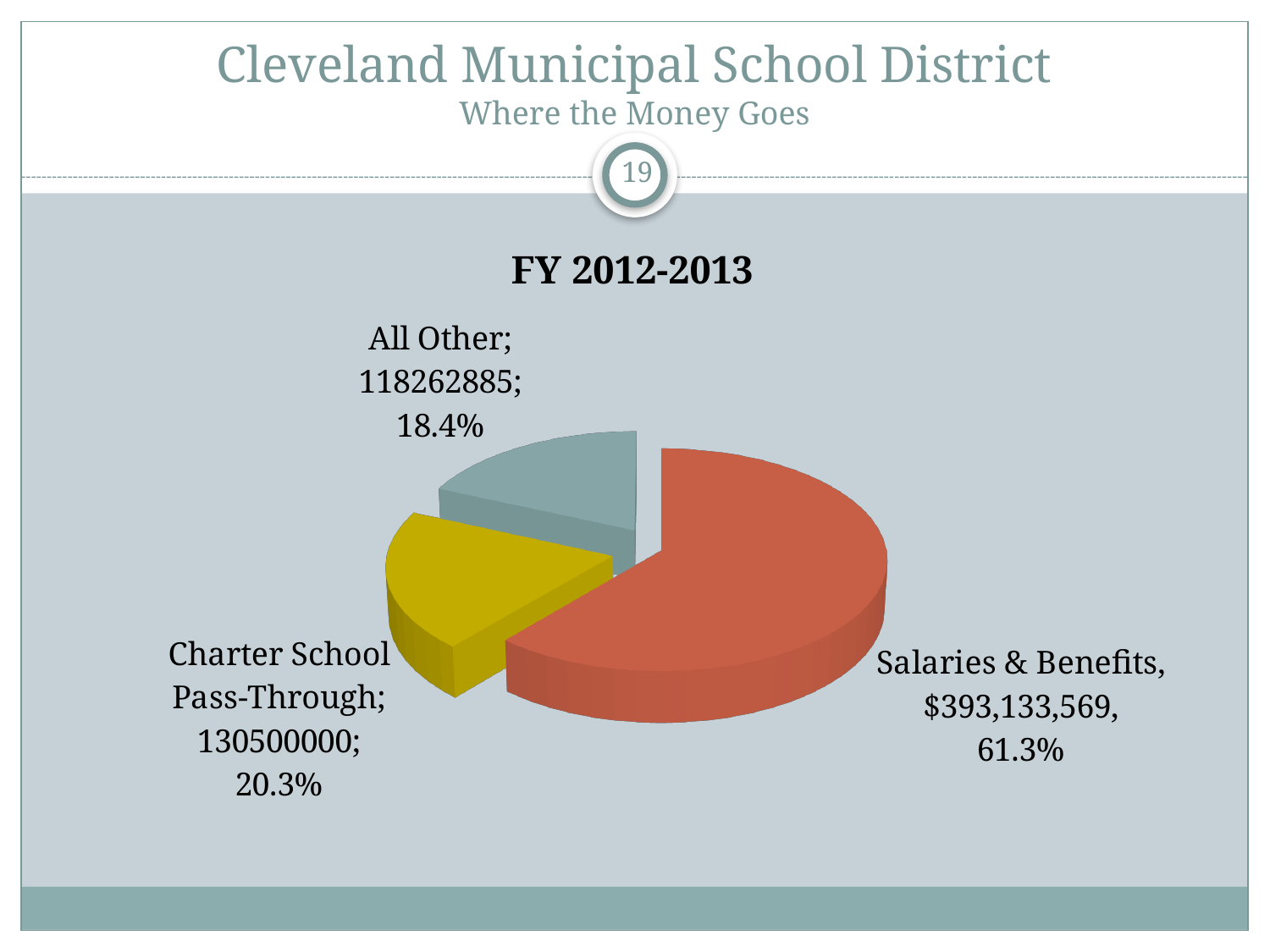
What share of the pie does Salaries & Benefits represent? 61.3% What is the difference in percentage share between Charter School Pass-Through and All Other? 1.9% What kind of chart is shown on the slide? pie chart What is the title of the chart? FY 2012-2013 What is the value for All Other? 118262885 Which category has the smallest slice? All Other What share of the pie does Charter School Pass-Through represent? 20.3% What share of the pie does All Other represent? 18.4% What is the value for Salaries & Benefits? $393,133,569 What is the value for Charter School Pass-Through? 130500000 How many slices does the pie chart have? 3 Which category has the largest slice? Salaries & Benefits